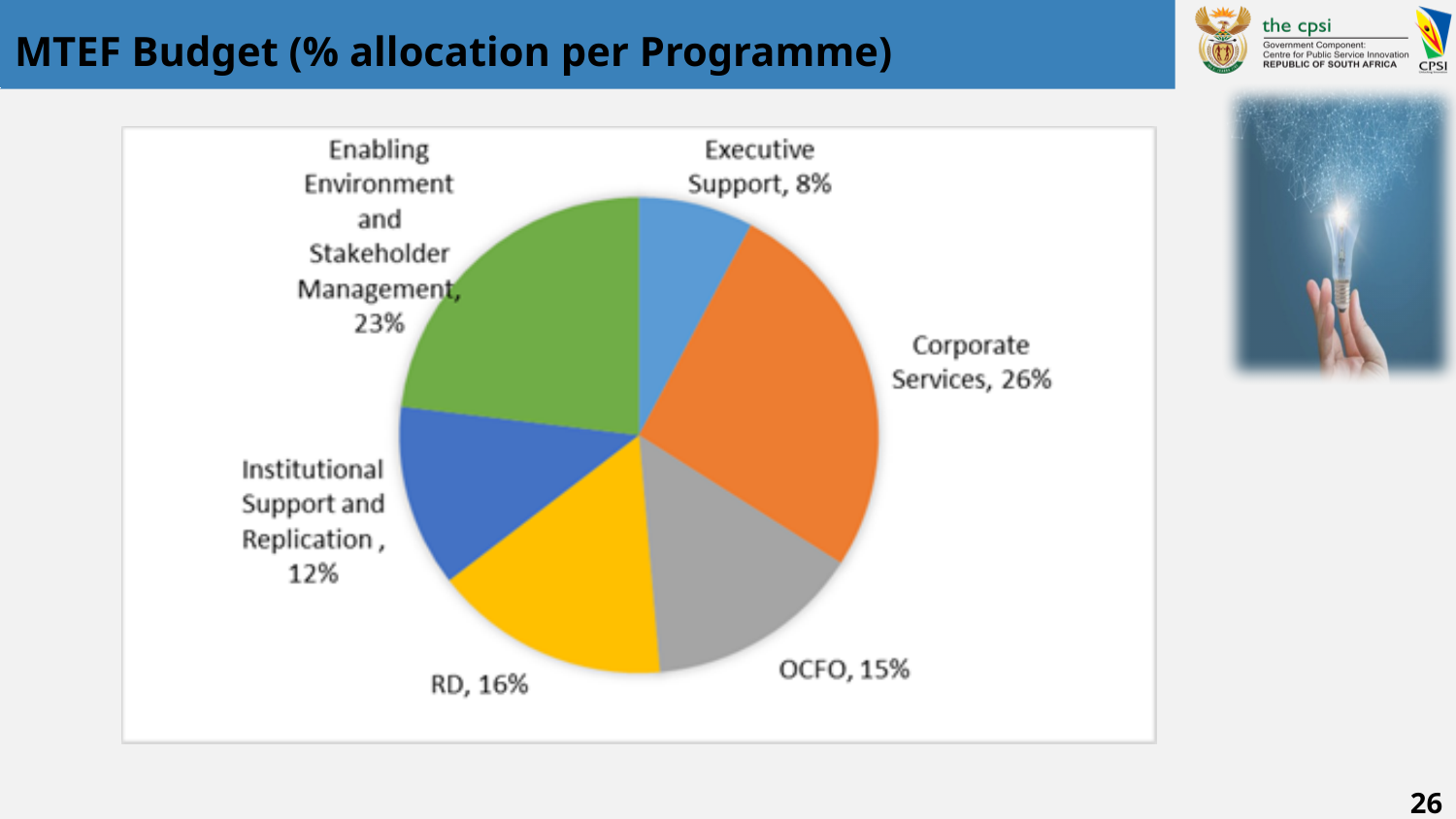
Which receives a larger allocation, RD or OCFO? RD How many programmes are shown in the pie chart? 6 What percentage of the MTEF budget is allocated to Executive Support? 8% What percentage of the MTEF budget is allocated to Institutional Support and Replication? 12% What percentage of the MTEF budget is allocated to Corporate Services? 26% What colour is the slice for Enabling Environment and Stakeholder Management? Green Which programme receives the largest share of the MTEF budget? Corporate Services Which programme receives the smallest share of the MTEF budget? Executive Support What percentage of the MTEF budget is allocated to OCFO? 15% What percentage of the MTEF budget is allocated to RD? 16% What is the difference in percentage points between the Corporate Services and Executive Support allocations? 18 What kind of chart is shown on the slide? Pie chart